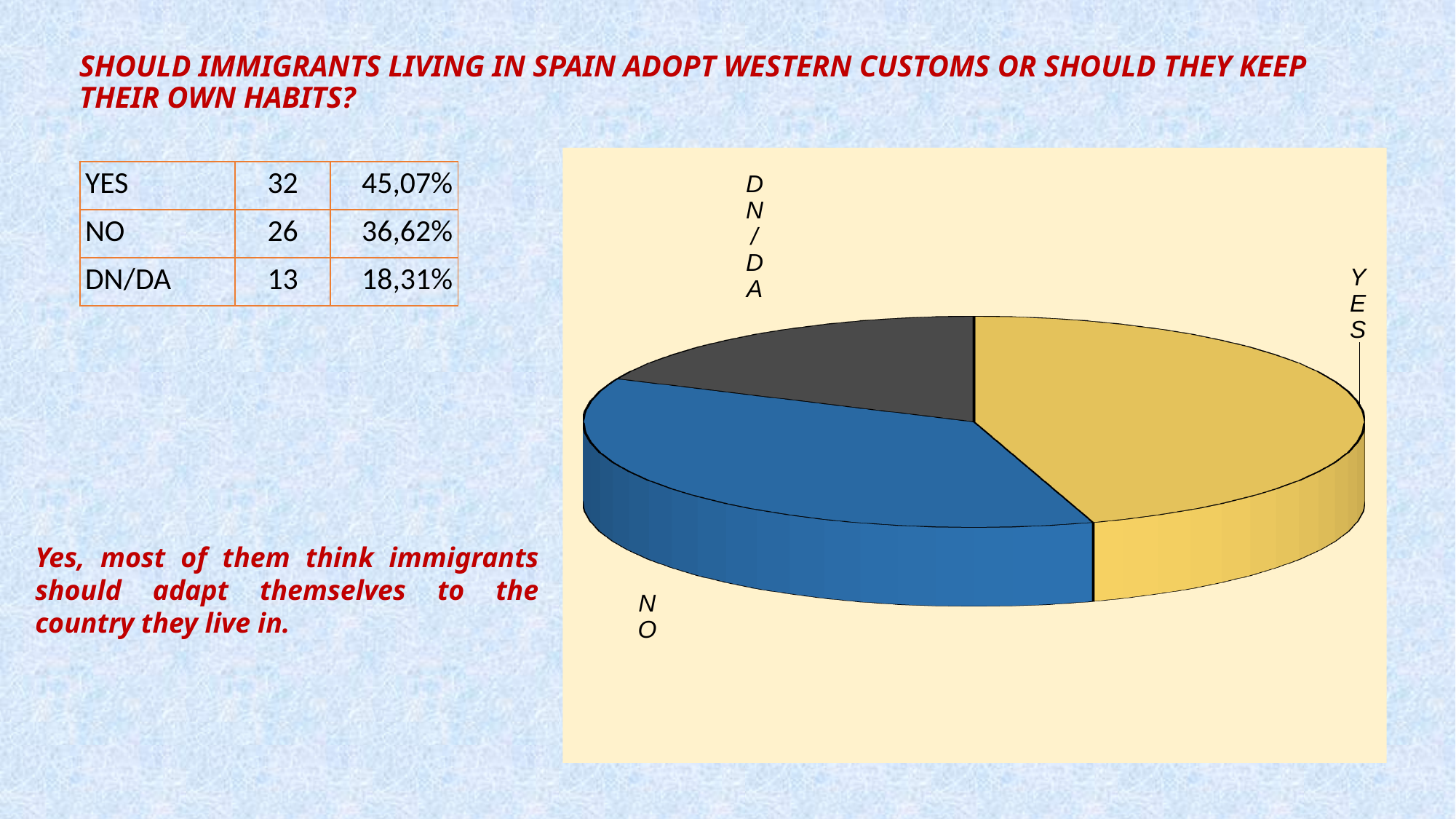
Which category has the smallest slice of the pie chart? DN/DA Which category has the largest slice of the pie chart? YES What share of the pie does the YES slice represent? 45,07% What is the difference in the number of respondents between YES and NO? 6 What share of the pie does the DN/DA slice represent? 18,31% What share of the pie does the NO slice represent? 36,62% How many respondents answered DN/DA? 13 What kind of chart is shown on the slide? pie chart How many respondents answered YES? 32 How many slices does the pie chart have? 3 Which slice is larger, NO or DN/DA? NO What colour is the NO slice of the pie chart? blue